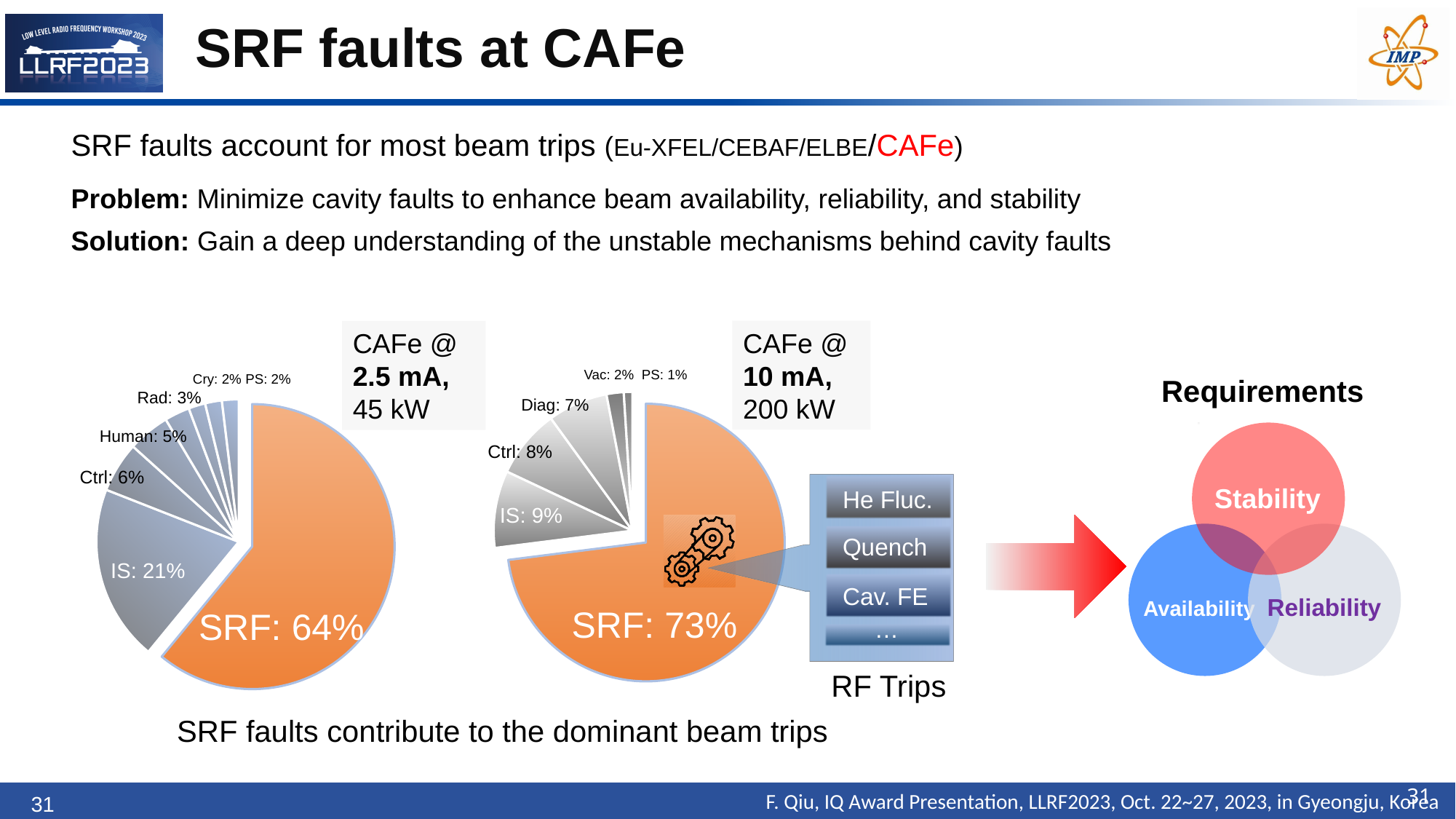
How many slices does the left pie chart (CAFe @ 2.5 mA) have? 8 In the right pie chart (CAFe @ 10 mA), which category has the smallest share? PS In the right pie chart (CAFe @ 10 mA), what is the share for Diag? 7% How many slices does the right pie chart (CAFe @ 10 mA) have? 6 What is the difference between the SRF share in the right pie chart (10 mA) and the SRF share in the left pie chart (2.5 mA)? 9% In the left pie chart (CAFe @ 2.5 mA, 45 kW), what share of beam trips is attributed to SRF? 64% In the left pie chart (CAFe @ 2.5 mA), which category has the largest share? SRF In the right pie chart (CAFe @ 10 mA, 200 kW), what share of beam trips is attributed to SRF? 73% In the right pie chart (CAFe @ 10 mA), what is the difference between the IS share and the Ctrl share? 1% In the left pie chart (CAFe @ 2.5 mA), which is larger: the Ctrl share or the Human share? Ctrl What type of chart is used to show the beam trip breakdown at CAFe? Pie chart In the left pie chart (CAFe @ 2.5 mA), what is the share for IS? 21%